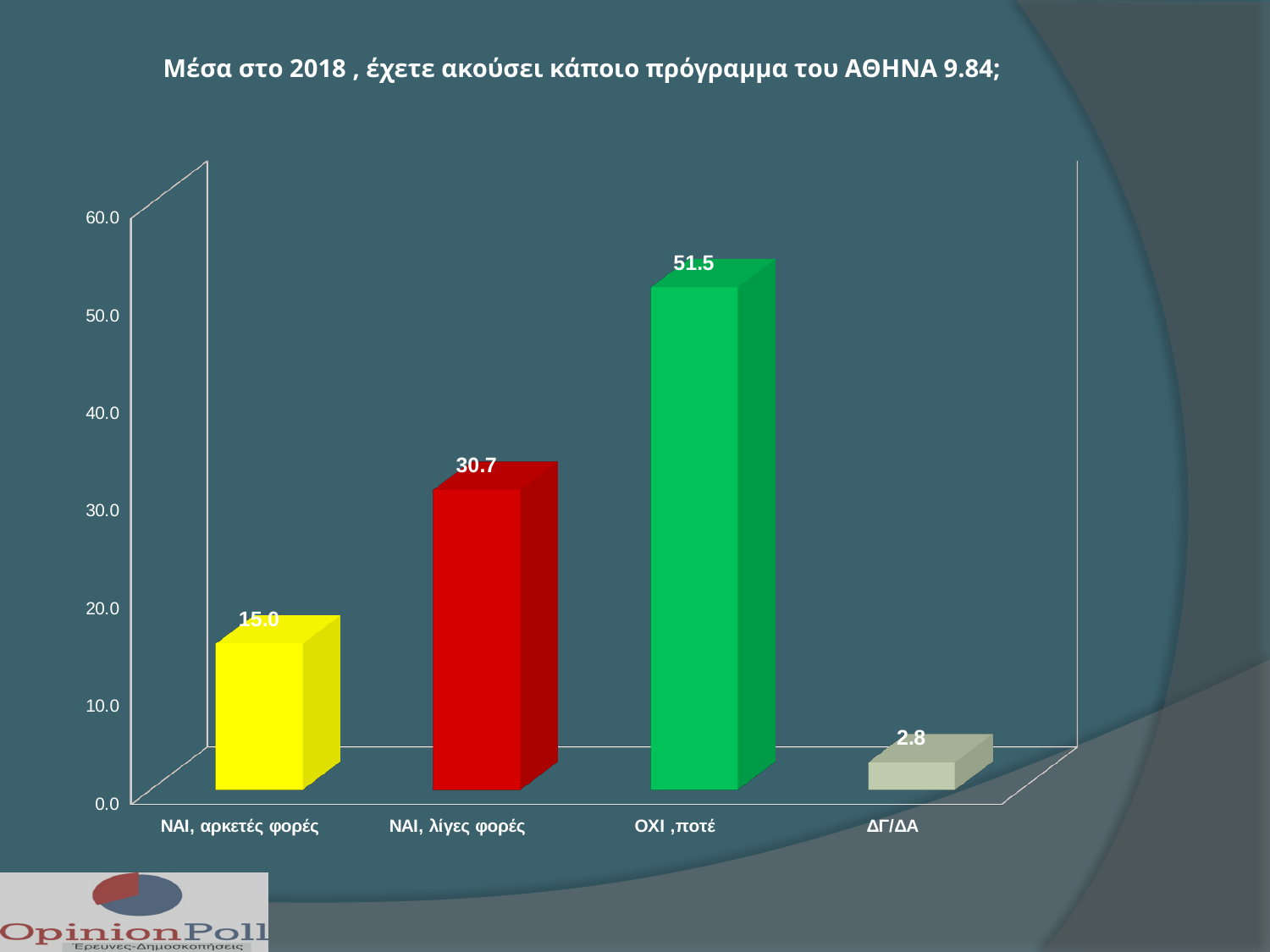
What is the value for ΝΑΙ, αρκετές φορές? 15.0 Which category has the lowest value? ΔΓ/ΔΑ Is the value for ΟΧΙ ,ποτέ greater or less than 50.0? greater What is the value for ΟΧΙ ,ποτέ? 51.5 How many categories are shown on the chart? 4 What is the difference between the values for ΟΧΙ ,ποτέ and ΝΑΙ, λίγες φορές? 20.8 What is the value for ΔΓ/ΔΑ? 2.8 What kind of chart is shown on the slide? bar chart Which is larger, the value for ΝΑΙ, αρκετές φορές or the value for ΝΑΙ, λίγες φορές? ΝΑΙ, λίγες φορές What is the value for ΝΑΙ, λίγες φορές? 30.7 Which category has the highest value? ΟΧΙ ,ποτέ What colour is the bar for ΟΧΙ ,ποτέ? green